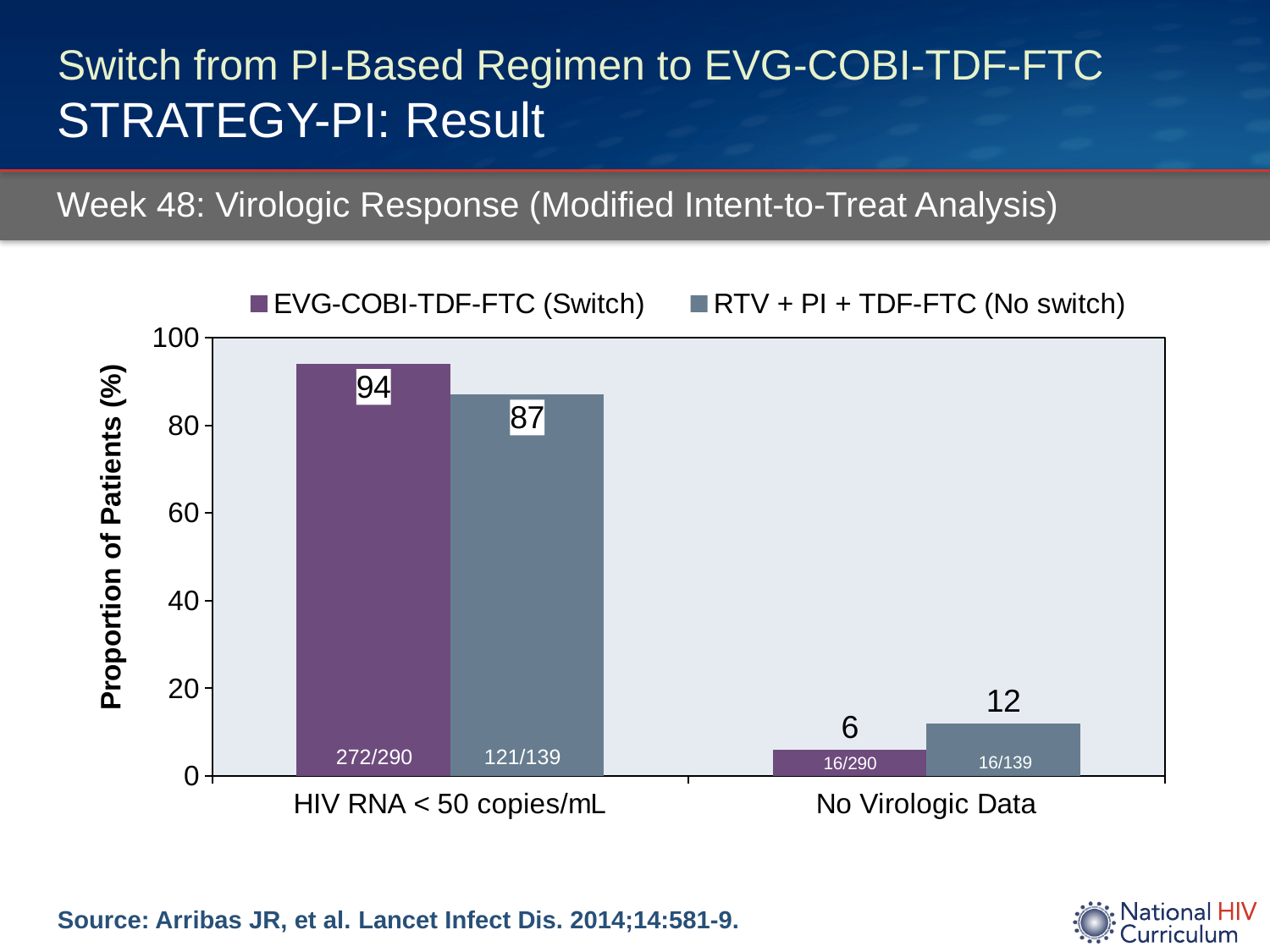
What is the difference between the two series' values in the HIV RNA < 50 copies/mL category? 7 What is the label of the y axis? Proportion of Patients (%) What is the difference between the two series' values in the No Virologic Data category? 6 What is the value for EVG-COBI-TDF-FTC (Switch) in the No Virologic Data category? 6 What kind of chart is shown on the slide? Bar chart What is the value for RTV + PI + TDF-FTC (No switch) in the No Virologic Data category? 12 Which series has the lower value in the No Virologic Data category? EVG-COBI-TDF-FTC (Switch) What is the value for RTV + PI + TDF-FTC (No switch) in the HIV RNA < 50 copies/mL category? 87 What is the value for EVG-COBI-TDF-FTC (Switch) in the HIV RNA < 50 copies/mL category? 94 Which series has the higher value in the HIV RNA < 50 copies/mL category? EVG-COBI-TDF-FTC (Switch) How many categories are shown on the x axis? 2 How many series does the legend list? 2